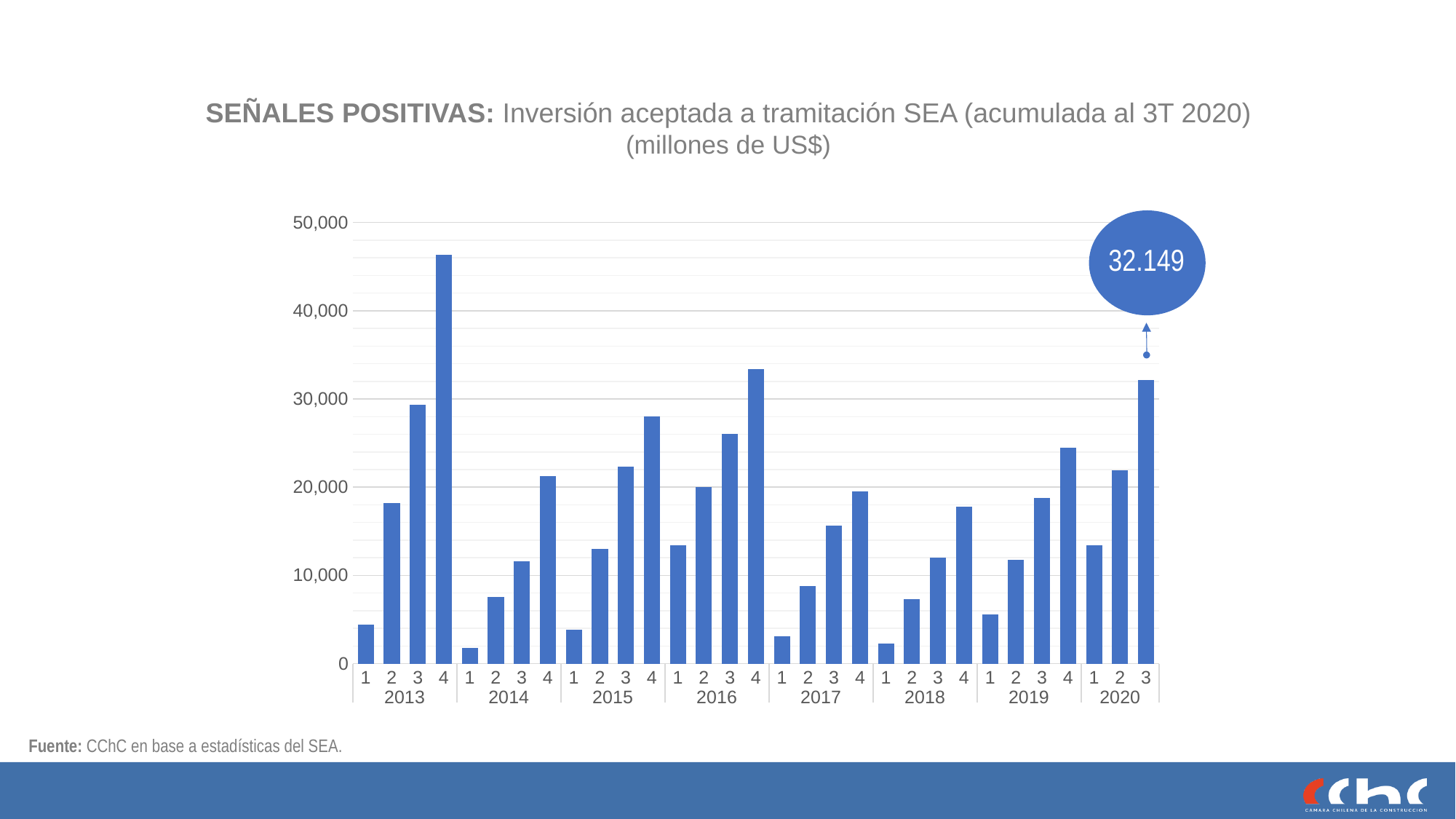
Within 2013, which quarter has the lowest bar? Quarter 1 Is the value for quarter 1 of 2014 greater or less than 10,000? less Which quarter has the highest bar in the chart? Quarter 4 of 2013 What value is labelled for the third quarter of 2020? 32.149 Which is larger, the value for quarter 4 of 2013 or quarter 4 of 2016? Quarter 4 of 2013 What kind of chart is shown on the slide? bar chart Do the values rise or fall from quarter 1 to quarter 3 of 2020? rise Which is larger, the value for quarter 4 of 2019 or quarter 4 of 2018? Quarter 4 of 2019 Is the value for quarter 4 of 2013 greater or less than 40,000? greater How many bars are plotted in the chart? 31 Is the value for quarter 4 of 2016 greater or less than 30,000? greater